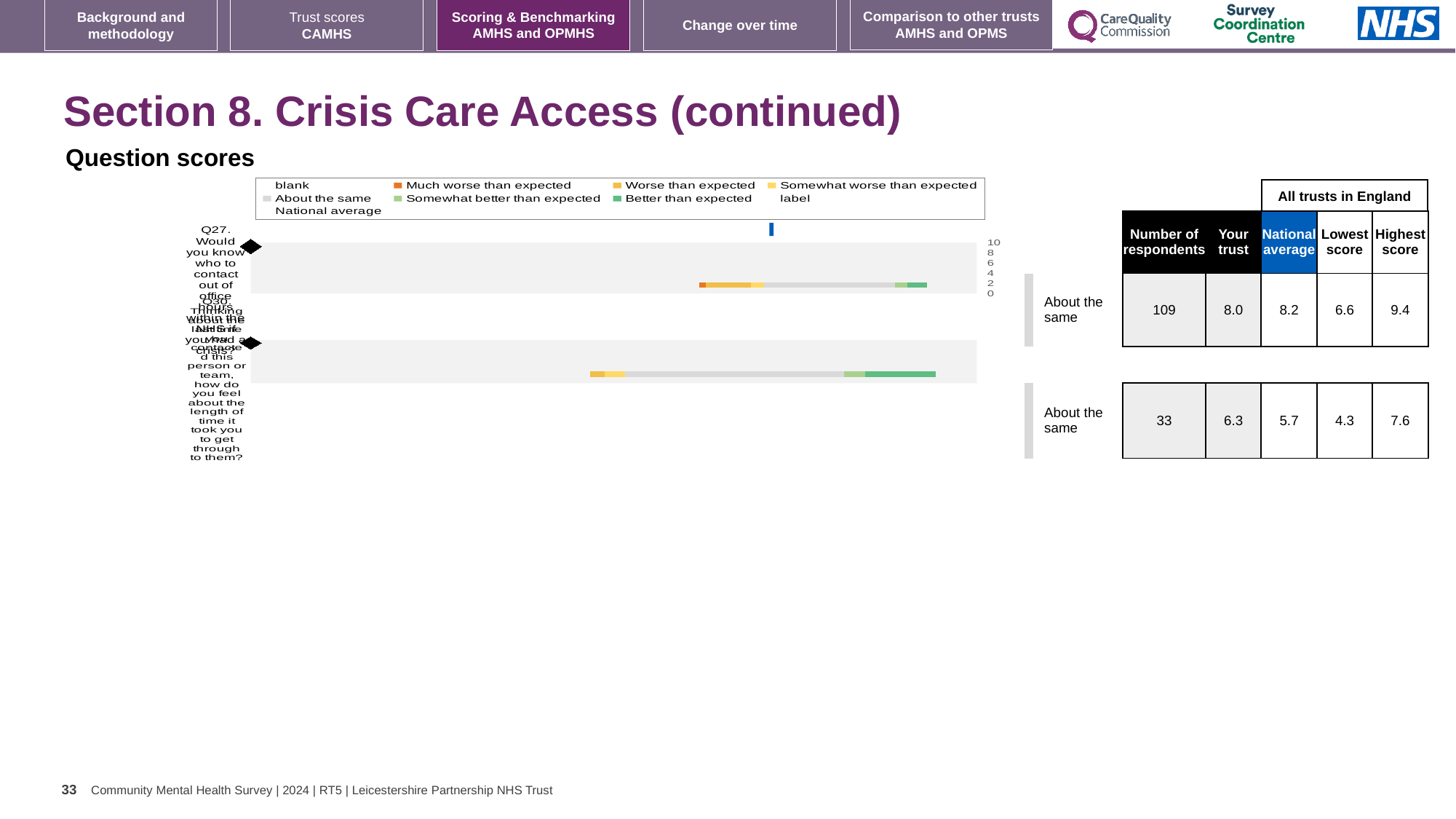
In the table beside the chart, what is the national average for the first question (Q27)? 8.2 In the table beside the chart, what is the "Your trust" score for the second question (Q30)? 6.3 What kind of chart is shown under "Question scores"? bar chart What is the highest tick value shown on the chart's axis? 10 In the table beside the chart, what is the number of respondents for the first question (Q27)? 109 In the table beside the chart, what is the difference between the highest score and the lowest score for the first question (Q27)? 2.8 In the table beside the chart, what is the highest score across all trusts in England for the second question (Q30)? 7.6 How many entries does the chart legend list? 9 In the table beside the chart, which is larger for the first question (Q27): the "Your trust" score or the national average? national average How many question categories (bars) are plotted in the chart? 2 Which legend entry is shown in orange-red in the chart? Much worse than expected What benchmark category is shown next to the chart for both questions? About the same